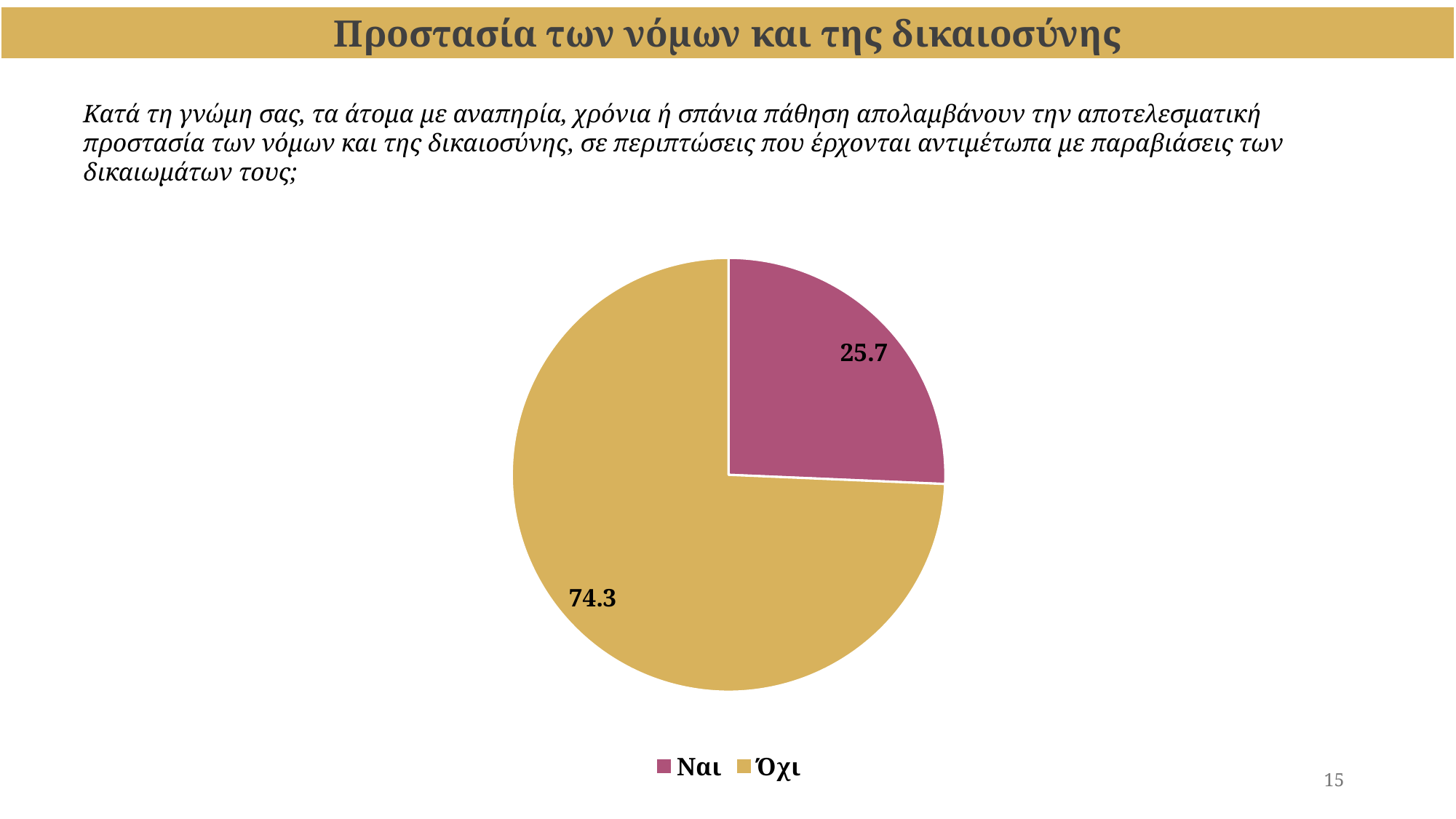
What colour is the slice for Ναι? magenta/purple Which category has the smallest slice? Ναι How many slices does the pie chart have? 2 How many entries does the legend list? 2 What is the difference between the values for Όχι and Ναι? 48.6 What is the title of the slide? Προστασία των νόμων και της δικαιοσύνης What is the value for Ναι? 25.7 Which is larger, the value for Ναι or the value for Όχι? Όχι What is the value for Όχι? 74.3 Which category has the largest slice? Όχι What is the total of the two slice values? 100 What kind of chart is shown on the slide? pie chart